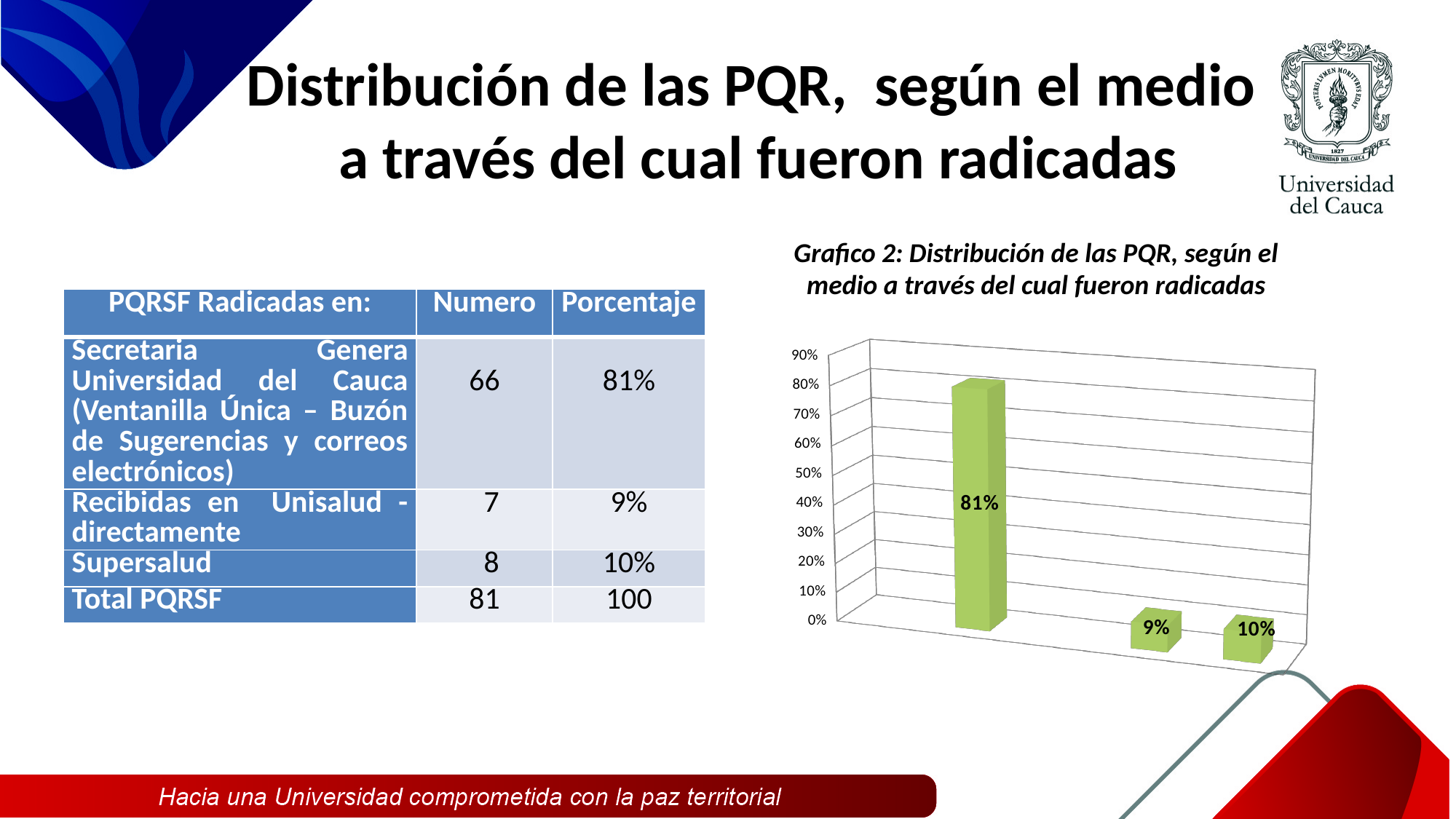
What kind of chart is shown on the slide? bar chart What is the value shown on the tallest bar in the chart? 81% Is the value of the leftmost bar greater or less than 50%? greater Which is larger, the middle bar or the rightmost bar? the rightmost bar (10%) What is the data label on the first (leftmost) bar in the chart? 81% What is the data label on the third (rightmost) bar in the chart? 10% What is the highest value shown on the chart's vertical axis? 90% What is the title of the chart (Grafico 2)? Distribución de las PQR, según el medio a través del cual fueron radicadas How many bars are plotted in the chart? 3 What is the data label on the middle bar in the chart? 9% What is the value shown on the shortest bar in the chart? 9% What is the difference in percentage points between the first bar (81%) and the third bar (10%)? 71